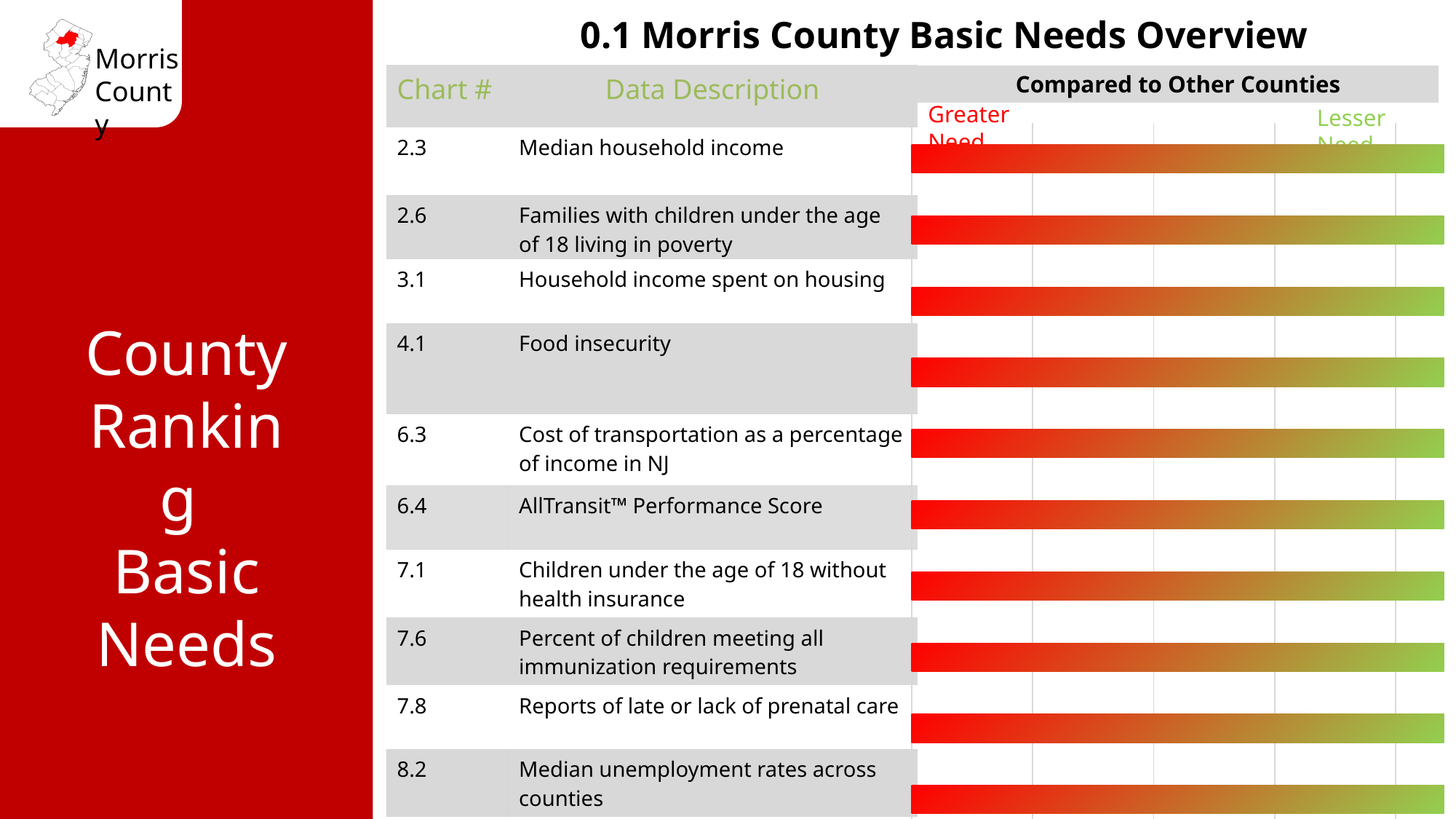
Which data description is listed for chart number 3.1? Household income spent on housing Which data description is listed for chart number 6.4? AllTransit™ Performance Score What is the title of the chart? 0.1 Morris County Basic Needs Overview How many data descriptions (rows) are listed in the chart? 10 What kind of chart is shown on the slide? bar chart Which data description is listed for chart number 8.2? Median unemployment rates across counties Which chart number is listed for Median household income? 2.3 Which chart number is listed for Food insecurity? 4.1 What do the two ends of the bar scale represent, from left to right? Greater Need to Lesser Need Which chart number is listed for Reports of late or lack of prenatal care? 7.8